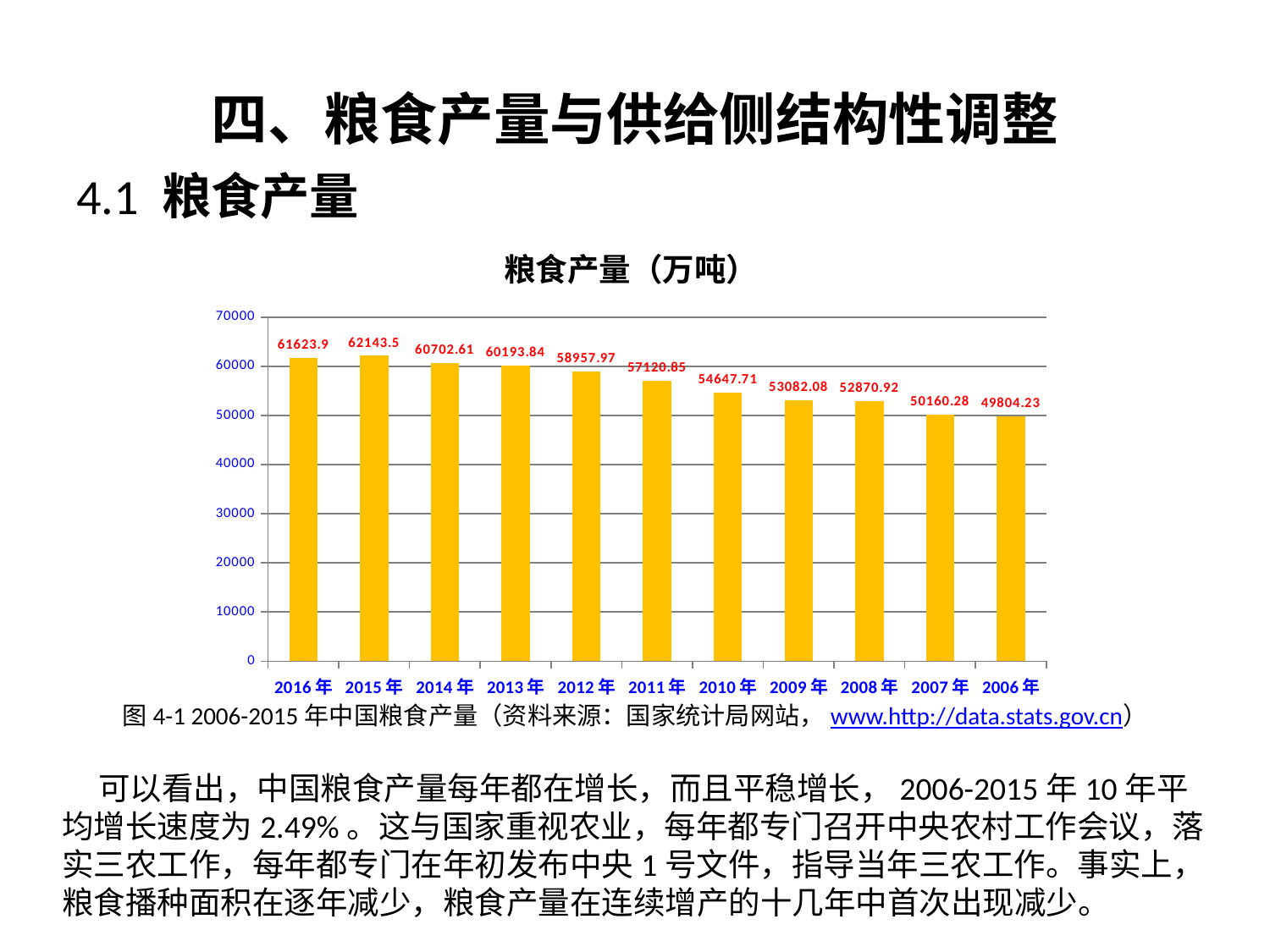
What is the grain output value shown for 2006年? 49804.23 Which is larger, the grain output for 2012年 or for 2011年? 2012年 What is the difference between the grain output for 2015年 and 2016年? 519.6 Which year has the lowest grain output in the chart? 2006年 What is the grain output value shown for 2015年? 62143.5 Is the value for 2006年 greater or less than 50000? less How many years are shown on the x axis of the chart? 11 Which year has the highest grain output in the chart? 2015年 What is the title of the chart? 粮食产量（万吨） What is the difference between the grain output for 2016年 and 2006年? 11819.67 What kind of chart is used to show grain output? bar chart What is the grain output value shown for 2010年? 54647.71